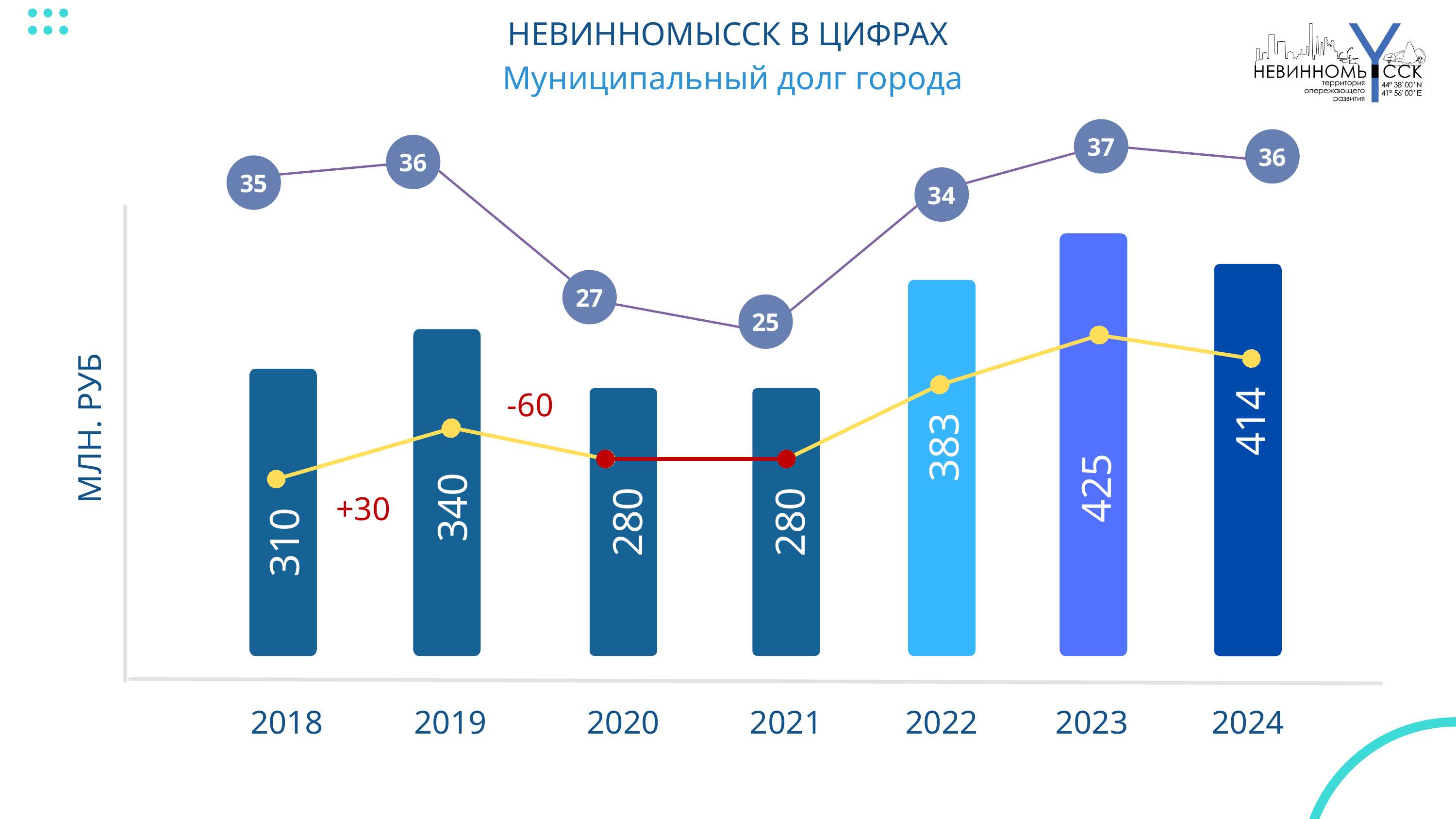
How many years are shown on the x axis? 7 Which year has the lowest value in the circled line series? 2021 What is the municipal debt value shown for 2023? 425 Do the municipal debt bars rise or fall from 2021 to 2023? Rise What unit is shown on the vertical axis label? МЛН. РУБ What value is shown in the circle above the 2021 bar? 25 Which year has a larger municipal debt bar, 2019 or 2024? 2024 What kind of chart is shown on the slide? Combined bar and line chart Which year has the highest municipal debt bar? 2023 What is the difference between the municipal debt in 2023 and in 2022? 42 What is the municipal debt value shown for 2018? 310 What value is shown in the circle above the 2023 bar? 37